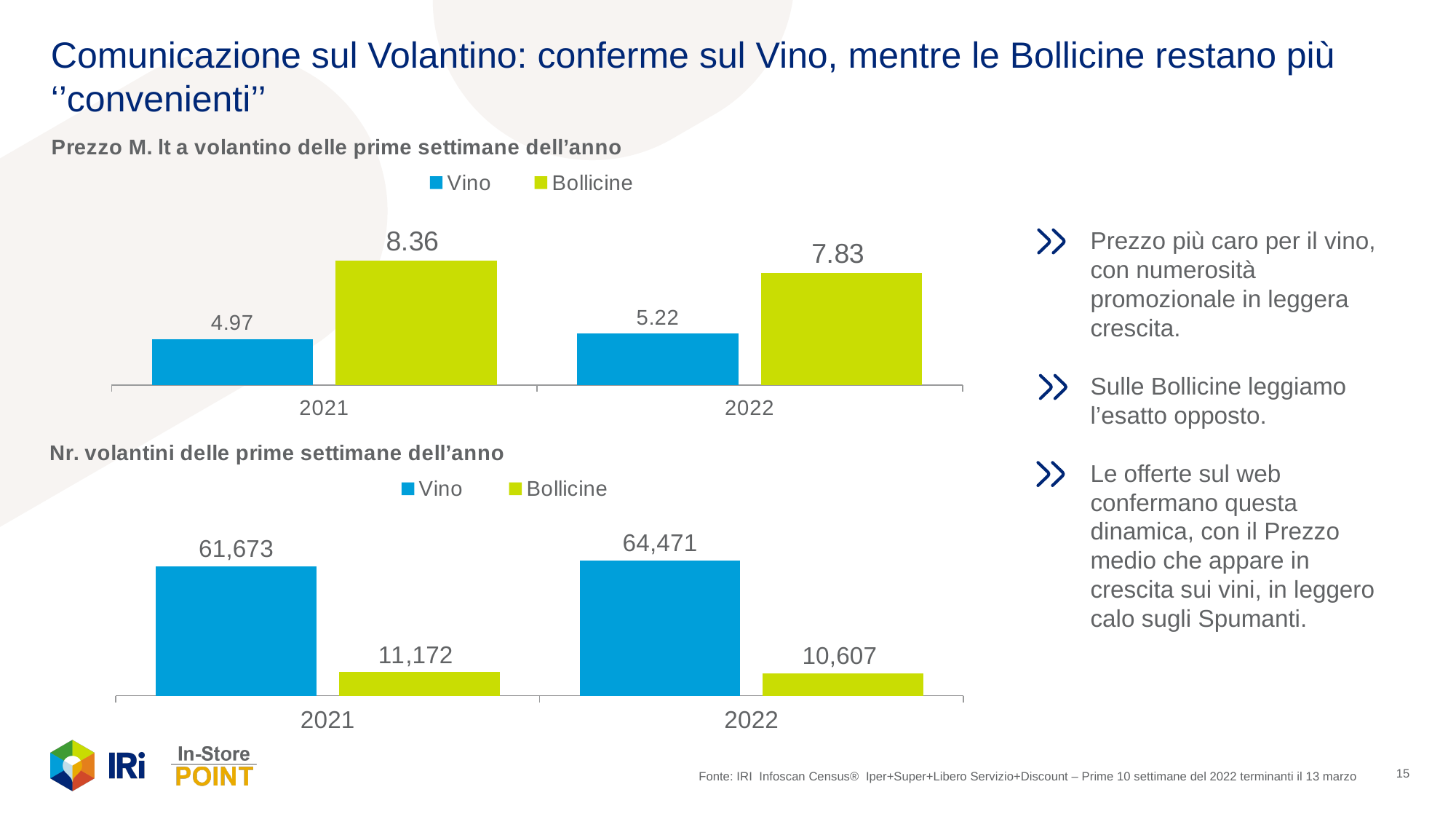
In the top chart (Prezzo M. lt a volantino delle prime settimane dell'anno), what is the value for Bollicine in 2022? 7.83 In the bottom chart (Nr. volantini delle prime settimane dell'anno), what is the value for Vino in 2022? 64,471 In the top chart (Prezzo M. lt a volantino delle prime settimane dell'anno), what is the difference between the Bollicine value in 2021 and in 2022? 0.53 In the top chart (Prezzo M. lt a volantino delle prime settimane dell'anno), how many series does the legend list? 2 In the top chart (Prezzo M. lt a volantino delle prime settimane dell'anno), what is the value for Vino in 2021? 4.97 In the bottom chart (Nr. volantini delle prime settimane dell'anno), which bar is the lowest? Bollicine 2022 In the bottom chart (Nr. volantini delle prime settimane dell'anno), what is the difference between the Vino value in 2022 and in 2021? 2,798 In the bottom chart (Nr. volantini delle prime settimane dell'anno), does the Bollicine value rise or fall from 2021 to 2022? fall What type of chart is the bottom chart (Nr. volantini delle prime settimane dell'anno)? bar chart In the top chart (Prezzo M. lt a volantino delle prime settimane dell'anno), does the Vino value rise or fall from 2021 to 2022? rise In the top chart (Prezzo M. lt a volantino delle prime settimane dell'anno), which series has the higher value in 2022, Vino or Bollicine? Bollicine In the bottom chart (Nr. volantini delle prime settimane dell'anno), what is the value for Bollicine in 2021? 11,172